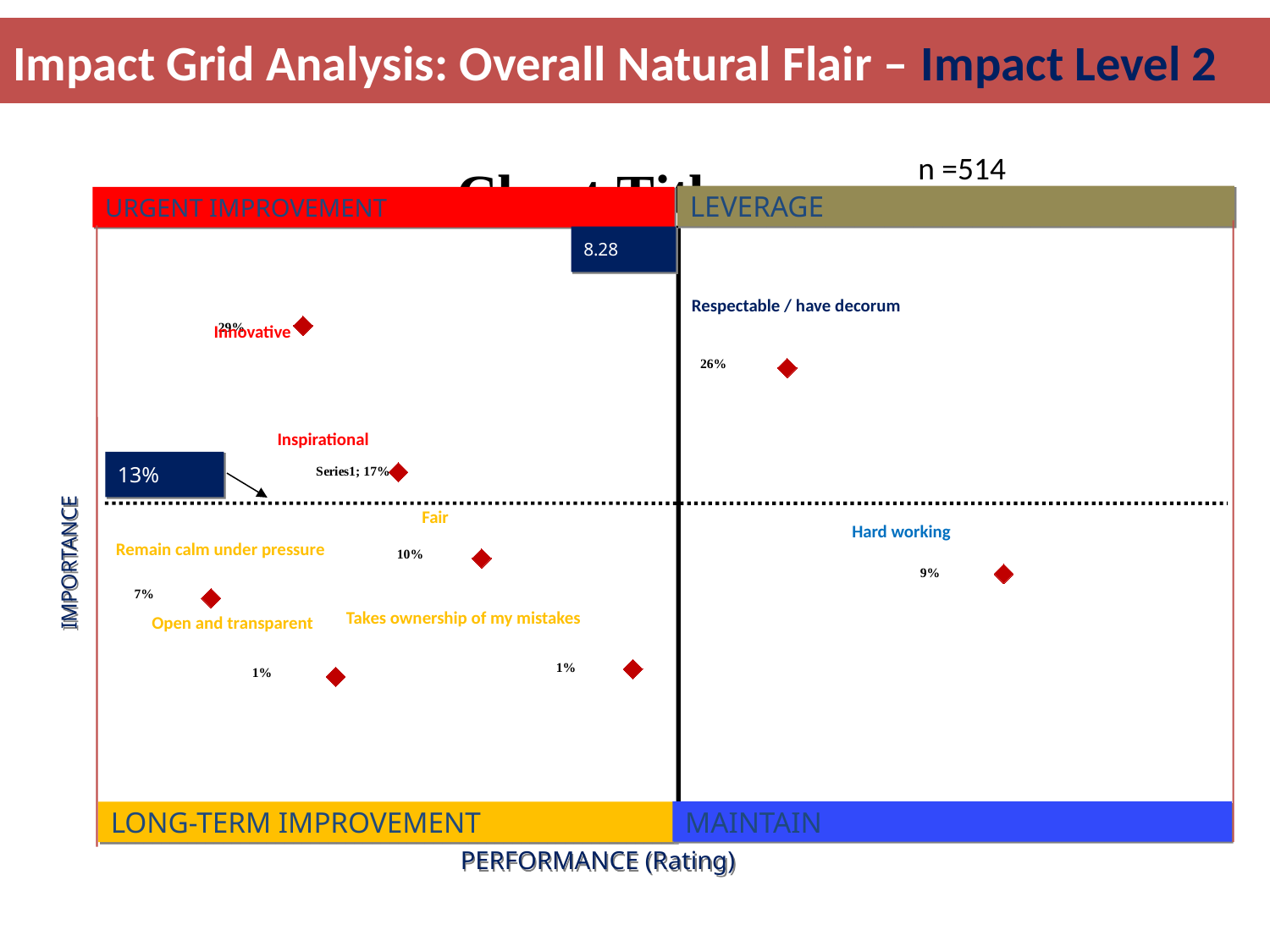
What is the data label for the Fair point? 10% Which quadrant is labelled in the top-right of the chart? LEVERAGE Which has the larger data label, Fair or Hard working? Fair What kind of chart is shown on the slide? Scatter chart What is the data label for the Respectable / have decorum point? 26% What is the difference between the data labels for Innovative and Respectable / have decorum? 3% What is the label of the vertical axis? IMPORTANCE What is the data label for the Hard working point? 9% What is the data label for the Innovative point? 29% How many data points are plotted on the chart? 8 What is the data label for the Remain calm under pressure point? 7% Which labelled point has the highest percentage data label? Innovative